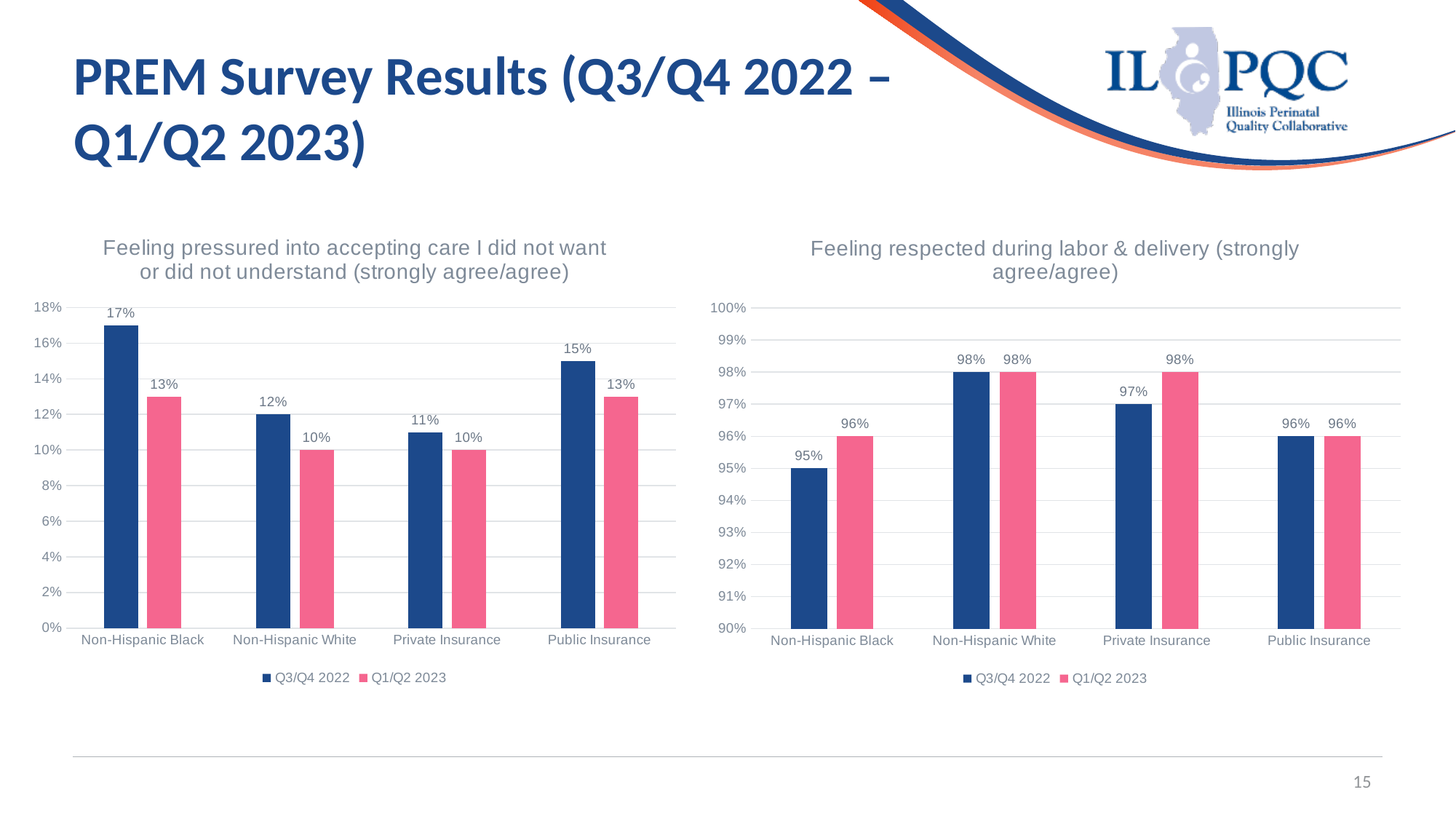
What kind of chart is the 'Feeling respected during labor & delivery' chart? Bar chart In the 'Feeling pressured into accepting care I did not want or did not understand' chart, what is the Q3/Q4 2022 value for Non-Hispanic Black? 17% In the 'Feeling respected during labor & delivery' chart, which category has the lowest Q3/Q4 2022 value? Non-Hispanic Black In the 'Feeling pressured into accepting care I did not want or did not understand' chart, what is the difference between the Q3/Q4 2022 and Q1/Q2 2023 values for Non-Hispanic Black? 4% In the 'Feeling respected during labor & delivery' chart, what is the Q1/Q2 2023 value for Non-Hispanic Black? 96% In the 'Feeling pressured into accepting care I did not want or did not understand' chart, what colour are the Q1/Q2 2023 bars? Pink In the 'Feeling pressured into accepting care I did not want or did not understand' chart, how many categories are shown on the x axis? 4 In the 'Feeling respected during labor & delivery' chart, how many series does the legend list? 2 In the 'Feeling pressured into accepting care I did not want or did not understand' chart, which category has the highest Q3/Q4 2022 value? Non-Hispanic Black In the 'Feeling respected during labor & delivery' chart, which is larger for Private Insurance: the Q3/Q4 2022 value or the Q1/Q2 2023 value? Q1/Q2 2023 In the 'Feeling pressured into accepting care I did not want or did not understand' chart, what is the Q1/Q2 2023 value for Public Insurance? 13% In the 'Feeling respected during labor & delivery' chart, what is the Q3/Q4 2022 value for Private Insurance? 97%